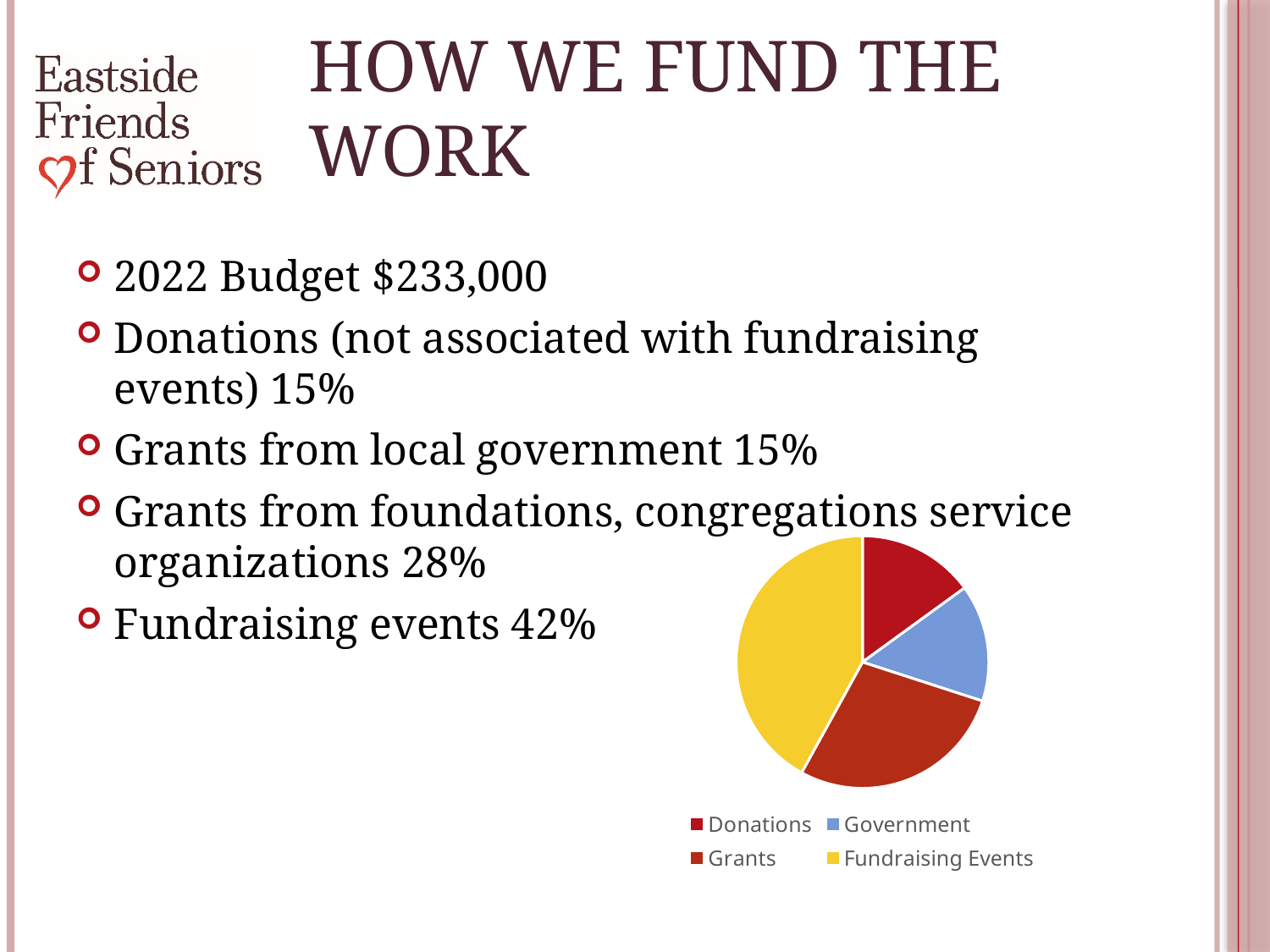
What kind of chart is shown on the slide? pie chart What colour is the Fundraising Events slice in the pie chart? yellow What share of the pie does Donations represent? 15% Which is larger in the pie chart, Fundraising Events or Grants? Fundraising Events How many slices does the pie chart have? 4 What share of the pie does Grants represent? 28% Which is larger in the pie chart, Grants or Government? Grants Which slice of the pie chart is the largest? Fundraising Events What is the difference in percentage points between the Fundraising Events share and the Grants share? 14 What share of the pie does Fundraising Events represent? 42% Which legend entry is shown in blue? Government How many entries does the pie chart's legend list? 4